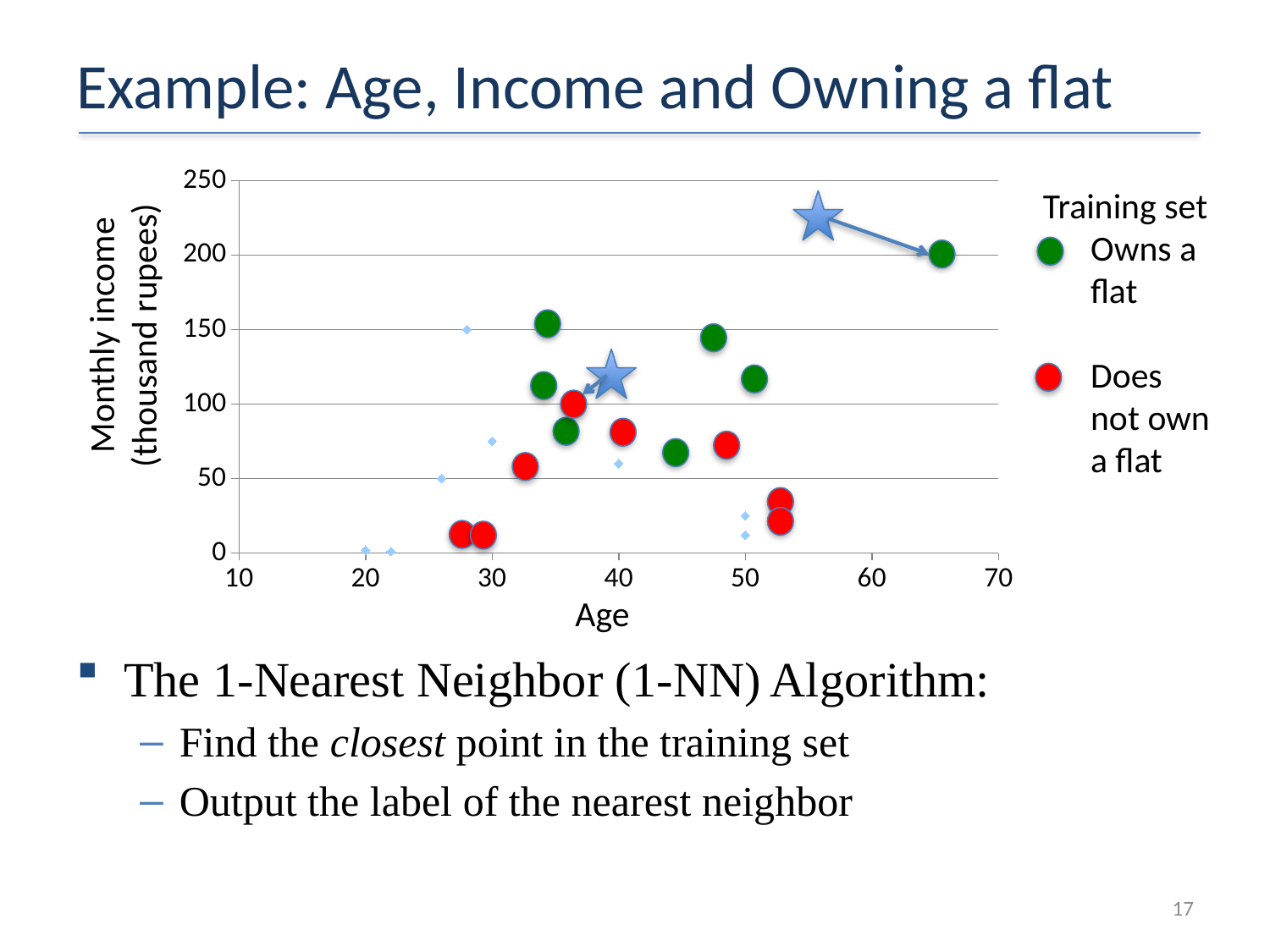
How many green 'Owns a flat' points are plotted on the chart? 7 Which colour of point has the highest monthly income on the chart, green or red? green What kind of chart is shown on the slide? scatter chart What is the label of the y axis of the chart? Monthly income (thousand rupees) What is the label of the x axis of the chart? Age Is the monthly income of the green point at the far right of the chart (around age 65) greater or less than 150? greater How many categories does the legend of the chart list? 2 How many red 'Does not own a flat' points are plotted on the chart? 8 Is the monthly income of the two red points near age 28-30 greater or less than 50? less Is the age of the rightmost green point greater or less than 60? greater What is the maximum value shown on the y axis of the chart? 250